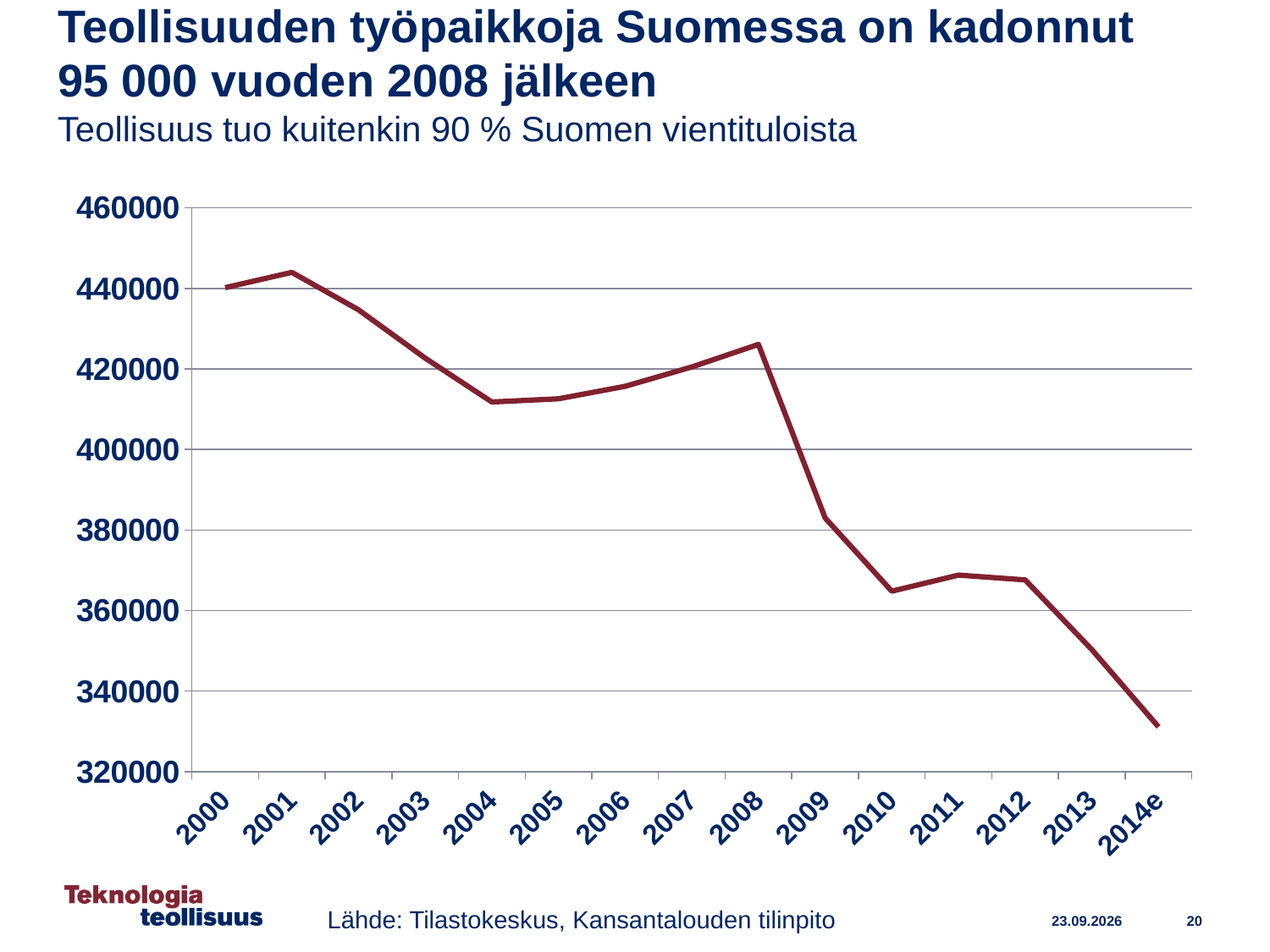
Overall, do the values rise or fall from 2000 to 2014e? fall Is the value for 2004 greater or less than 400000? greater Is the value for 2009 greater or less than 400000? less What kind of chart is shown on the slide? line chart How many years are plotted along the x axis of the chart? 15 Which year has the lowest value on the chart? 2014e Is the value for 2013 greater or less than 360000? less What is the source cited below the chart? Tilastokeskus, Kansantalouden tilinpito Which is larger, the value for 2008 or the value for 2009? 2008 Which year has the highest value on the chart? 2001